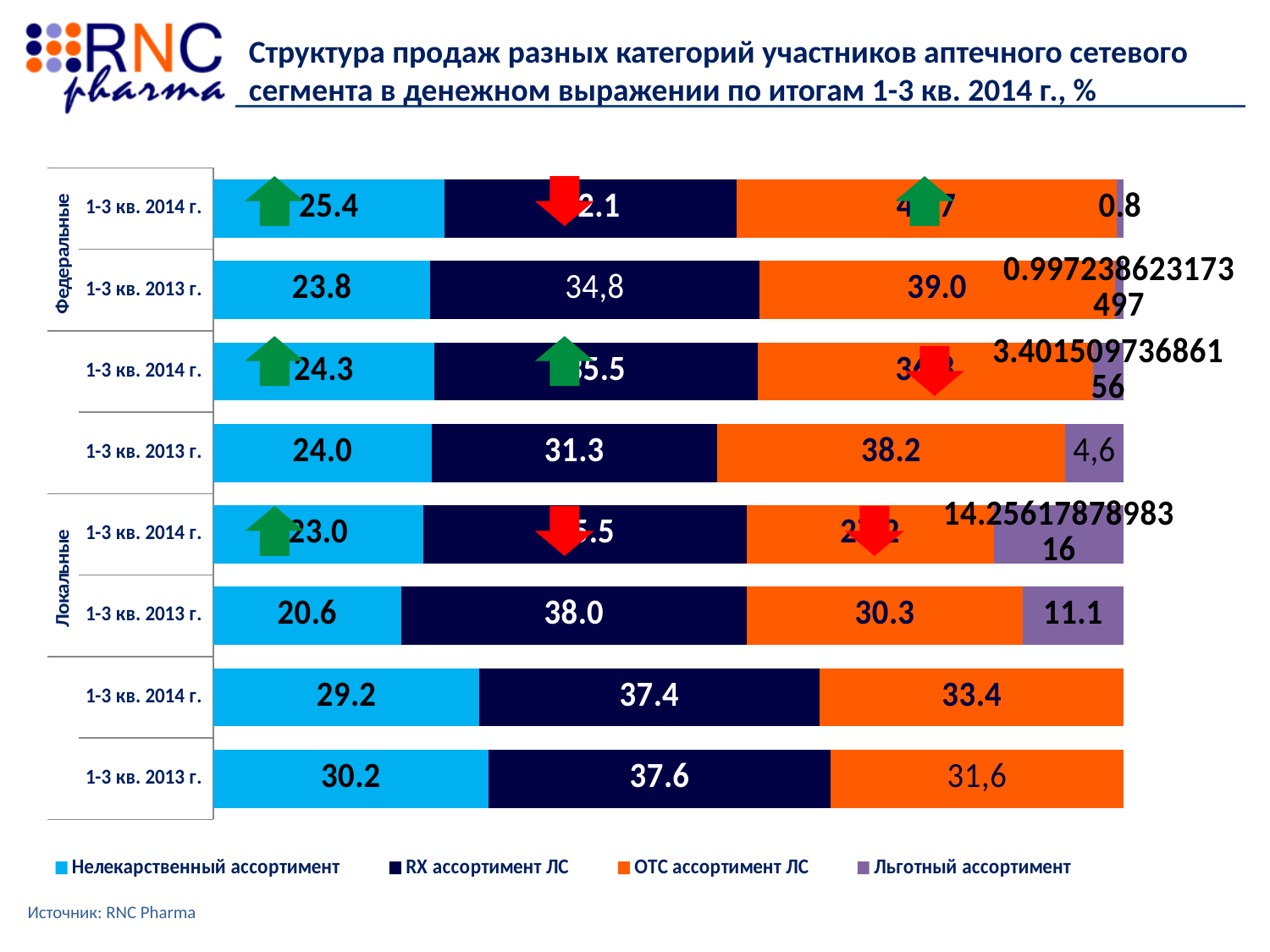
What is the value of OTC ассортимент ЛС for Федеральные in 1-3 кв. 2013 г.? 39.0 What is the value of Льготный ассортимент for Федеральные in 1-3 кв. 2014 г.? 0.8 What is the value of Нелекарственный ассортимент for Федеральные in 1-3 кв. 2013 г.? 23.8 Which series has the largest share in the Локальные 1-3 кв. 2013 г. bar? RX ассортимент ЛС What is the value of RX ассортимент ЛС for Локальные in 1-3 кв. 2013 г.? 38.0 For Локальные in 1-3 кв. 2013 г., what is the difference between RX ассортимент ЛС and OTC ассортимент ЛС? 7.7 How many series does the legend list? 4 What is the value of Нелекарственный ассортимент for Федеральные in 1-3 кв. 2014 г.? 25.4 What kind of chart is shown on the slide? Stacked bar chart For Федеральные in 1-3 кв. 2013 г., which is larger: RX ассортимент ЛС or OTC ассортимент ЛС? OTC ассортимент ЛС How many bars are plotted in the chart? 8 What is the value of Льготный ассортимент for Локальные in 1-3 кв. 2013 г.? 11.1